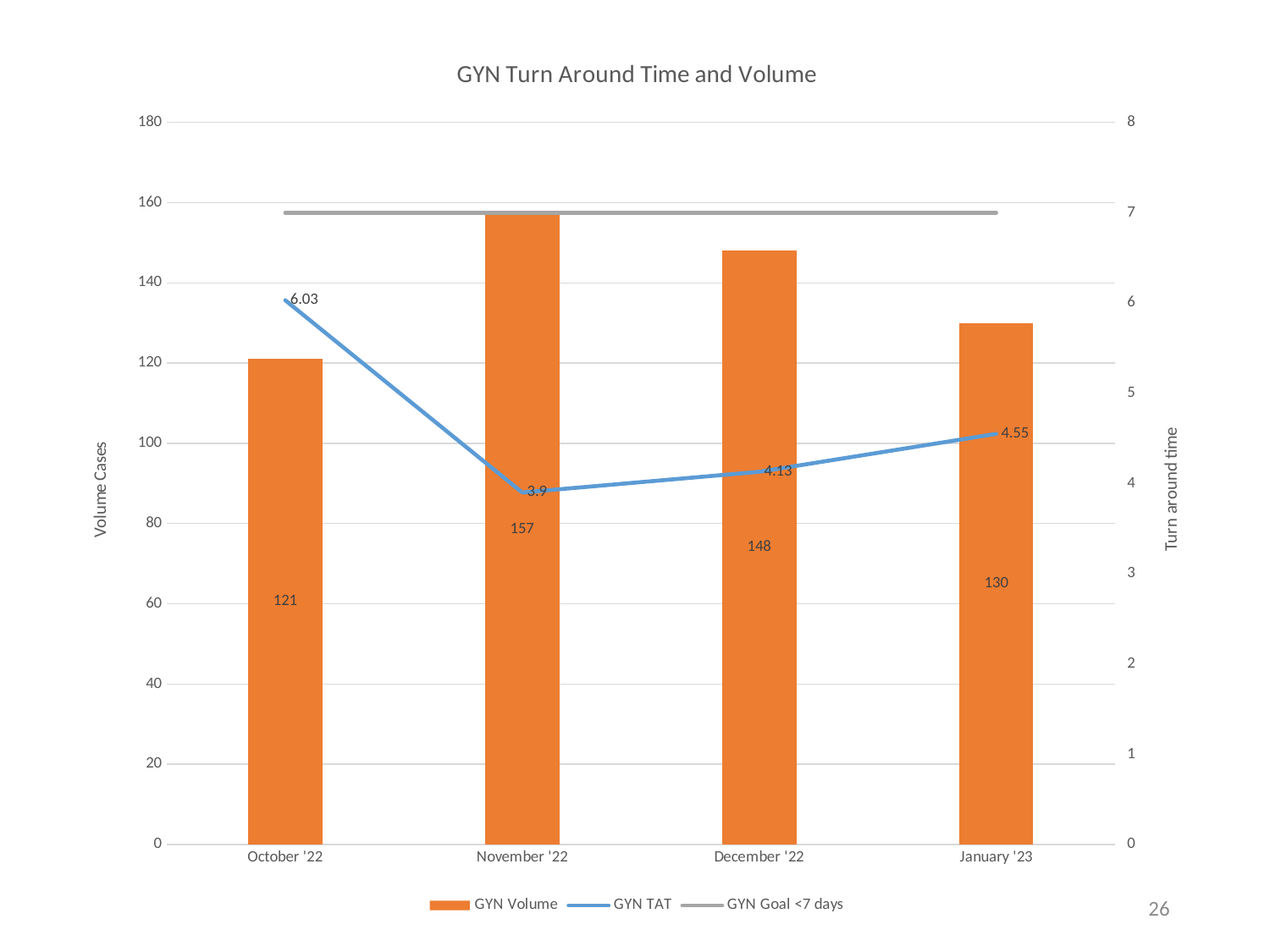
Which month has the lowest GYN TAT? November '22 What is the GYN TAT for January '23? 4.55 What is the title of the chart? GYN Turn Around Time and Volume Does the GYN TAT rise or fall from October '22 to November '22? fall How many months are shown on the x axis? 4 What is the GYN Volume for November '22? 157 What is the difference in GYN Volume between November '22 and October '22? 36 Which is larger, the GYN Volume for December '22 or for January '23? December '22 Is the GYN TAT for December '22 greater or less than 5? less Which month has the highest GYN Volume? November '22 What is the GYN TAT for October '22? 6.03 How many series does the legend list? 3